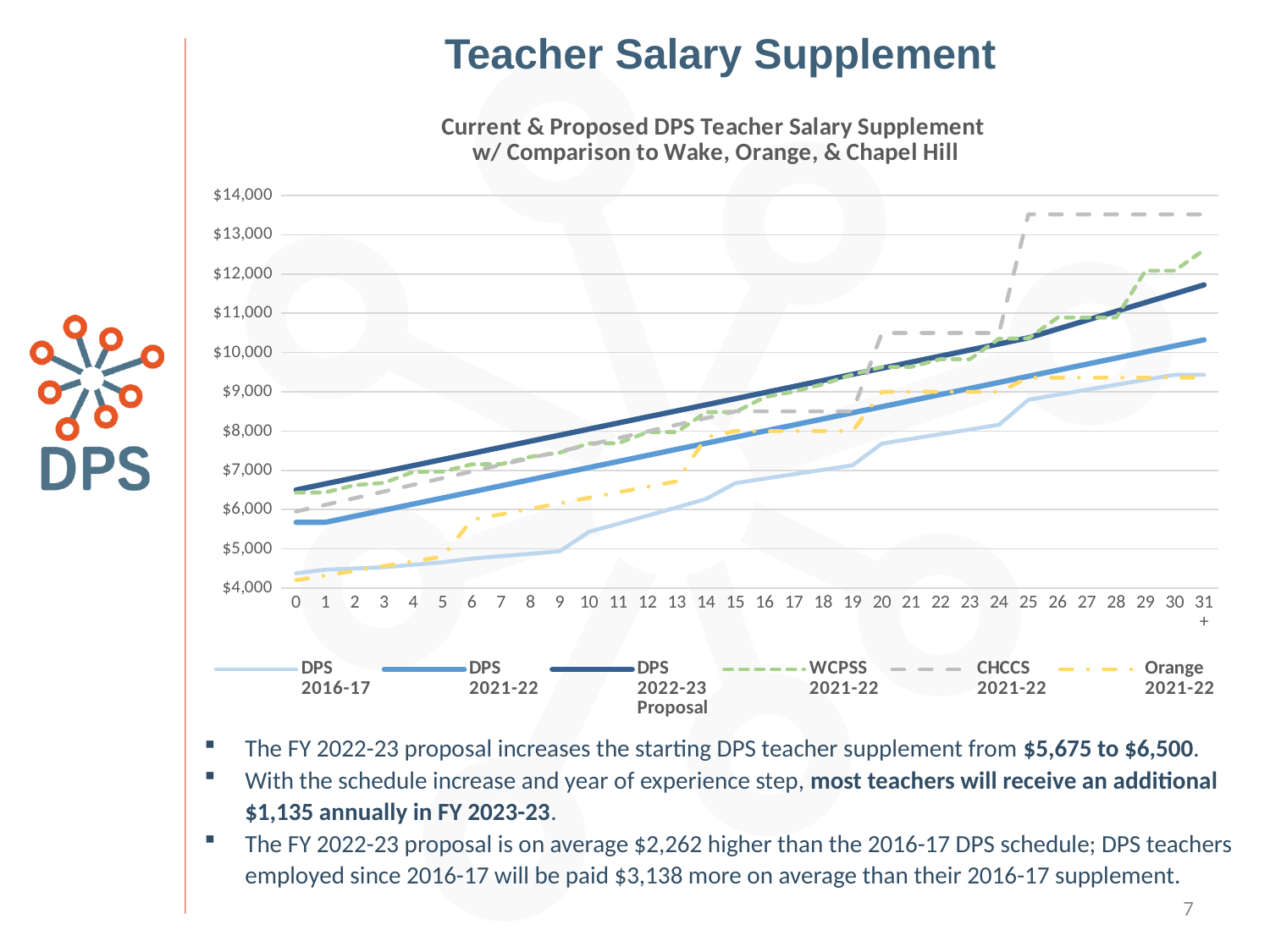
What is the title of the chart? Current & Proposed DPS Teacher Salary Supplement w/ Comparison to Wake, Orange, & Chapel Hill What kind of chart is shown on the slide? line chart Is the value for CHCCS 2021-22 at 31+ greater or less than $13,000? greater At year 10, which is larger: DPS 2021-22 or DPS 2016-17? DPS 2021-22 Do the values for DPS 2022-23 Proposal rise or fall as years of experience increase along the x axis? rise How many points are marked along the x axis of the chart (from 0 to 31+)? 32 Is the value for WCPSS 2021-22 at 31+ greater or less than $12,000? greater How many series does the chart legend list? 6 At year 25, which is larger: CHCCS 2021-22 or DPS 2022-23 Proposal? CHCCS 2021-22 Which series has the highest value at 31+ years of experience? CHCCS 2021-22 Is the value for DPS 2022-23 Proposal at 31+ greater or less than $11,000? greater